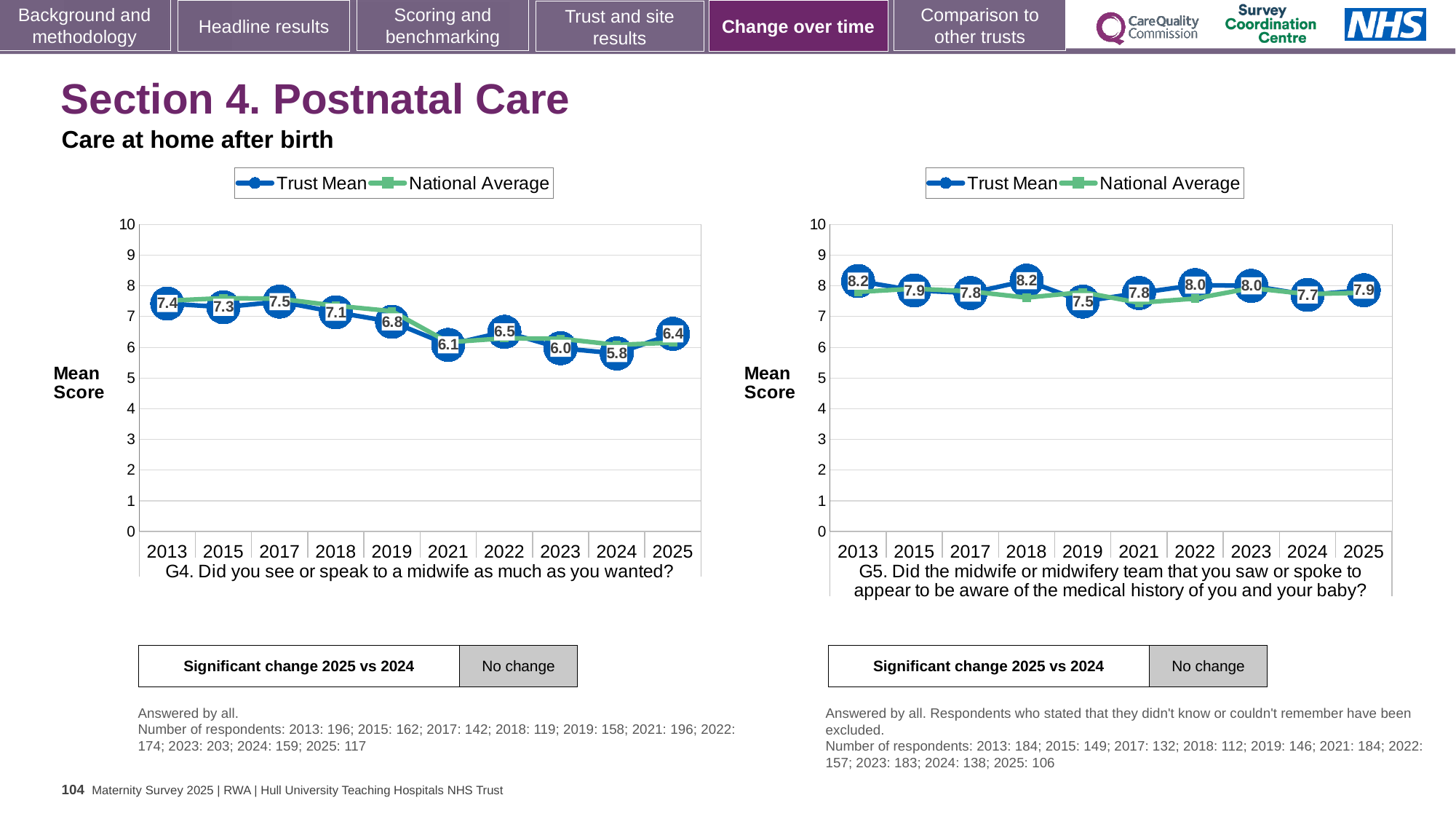
What type of chart is used for the G4 chart on the left? Line chart In the G4 chart on the left, what is the Trust Mean score for 2013? 7.4 In the G4 chart on the left, what is the difference between the Trust Mean scores for 2013 and 2025? 1.0 In the G5 chart on the right, is the Trust Mean score higher in 2018 or in 2024? 2018 In the G5 chart on the right, which year has the lowest Trust Mean score? 2019 How many years are plotted on the x axis of the G4 chart on the left? 10 In the G4 chart on the left, which year has the lowest Trust Mean score? 2024 How many series does the legend of the G5 chart on the right list? 2 In the G5 chart on the right, what is the Trust Mean score for 2019? 7.5 In the G4 chart on the left, what is the Trust Mean score for 2024? 5.8 In the G5 chart on the right, what is the Trust Mean score for 2025? 7.9 In the G4 chart on the left, which year has the highest Trust Mean score? 2017